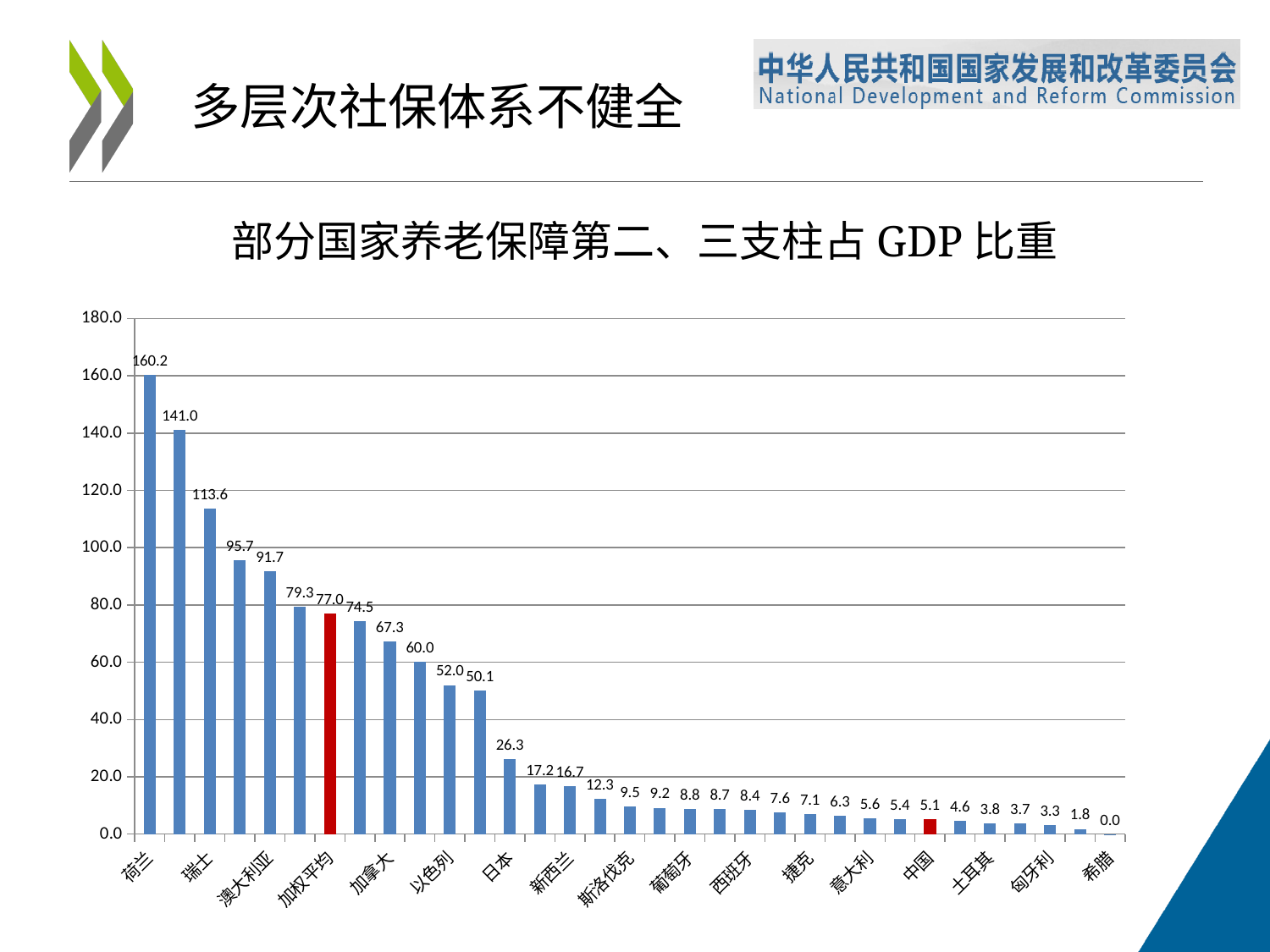
What is the value for 中国? 5.1 What is the value for 荷兰? 160.2 What is the value for 日本? 26.3 What is the difference between the values for 加权平均 and 中国? 71.9 Which category has the lowest value? 希腊 Do the values rise or fall from left to right along the x axis? fall Is the value for 澳大利亚 greater or less than 80.0? greater Which is larger, the value for 加拿大 or the value for 以色列? 加拿大 What kind of chart is shown on the slide? bar chart What is the value for 加权平均? 77.0 What is the difference between the values for 荷兰 and 瑞士? 46.6 Which category has the highest value? 荷兰